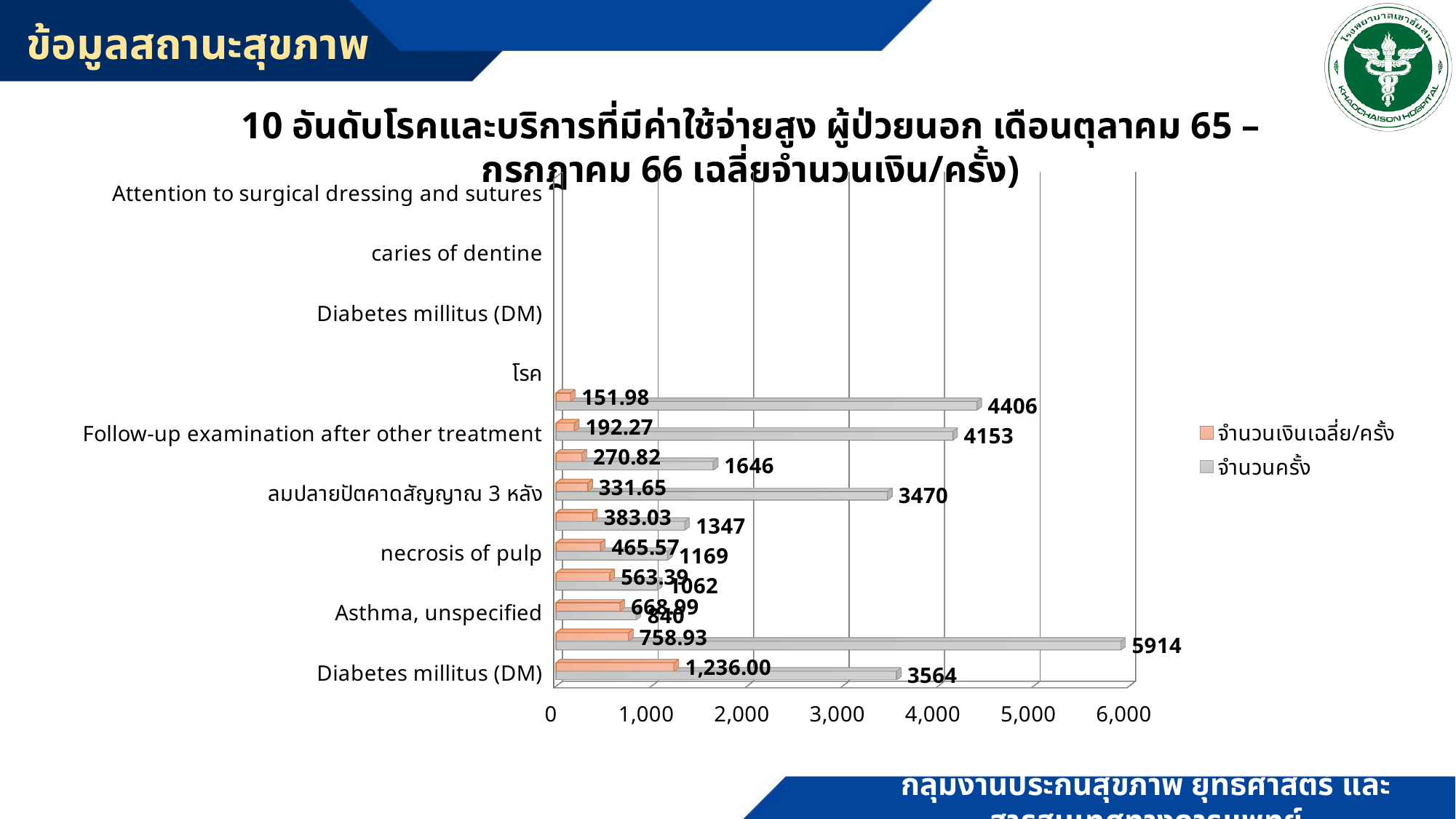
How many pairs of bars (categories) are plotted in the chart? 10 How many series does the legend list? 2 What is the highest value shown for the จำนวนครั้ง series? 5914 What is the จำนวนเงินเฉลี่ย/ครั้ง value for the bottom-most pair of bars in the chart? 1,236.00 What is the difference between the highest and lowest จำนวนครั้ง values (5914 and 840)? 5074 What is the lowest value shown for the จำนวนครั้ง series? 840 What is the lowest value shown for the จำนวนเงินเฉลี่ย/ครั้ง series? 151.98 What are the two series named in the legend? จำนวนเงินเฉลี่ย/ครั้ง and จำนวนครั้ง What kind of chart is shown on the slide? bar chart What is the จำนวนครั้ง value for the bottom-most pair of bars in the chart? 3564 What is the highest value shown for the จำนวนเงินเฉลี่ย/ครั้ง series? 1,236.00 Which series is drawn in orange according to the legend? จำนวนเงินเฉลี่ย/ครั้ง